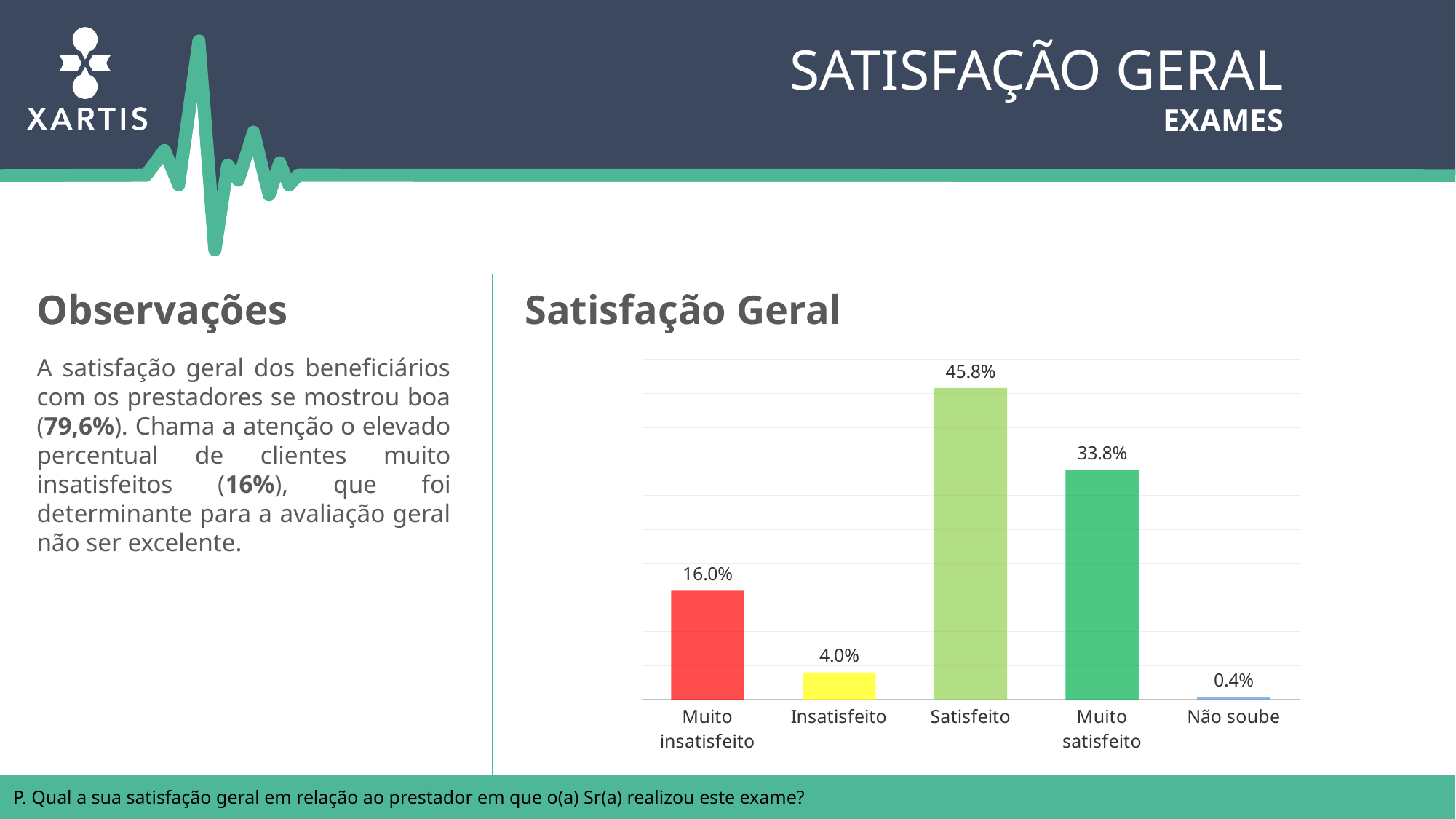
Which category has the highest value? Satisfeito What is the value for Não soube? 0.4% What kind of chart is shown? Bar chart What colour is the bar for Muito insatisfeito? Red What is the title of the chart? Satisfação Geral What is the value for Satisfeito? 45.8% Which is larger, Muito insatisfeito or Insatisfeito? Muito insatisfeito What is the difference between Muito insatisfeito and Insatisfeito? 12.0% What is the difference between Satisfeito and Muito satisfeito? 12.0% What is the value for Muito insatisfeito? 16.0% Which category has the lowest value? Não soube How many categories are shown in the chart? 5